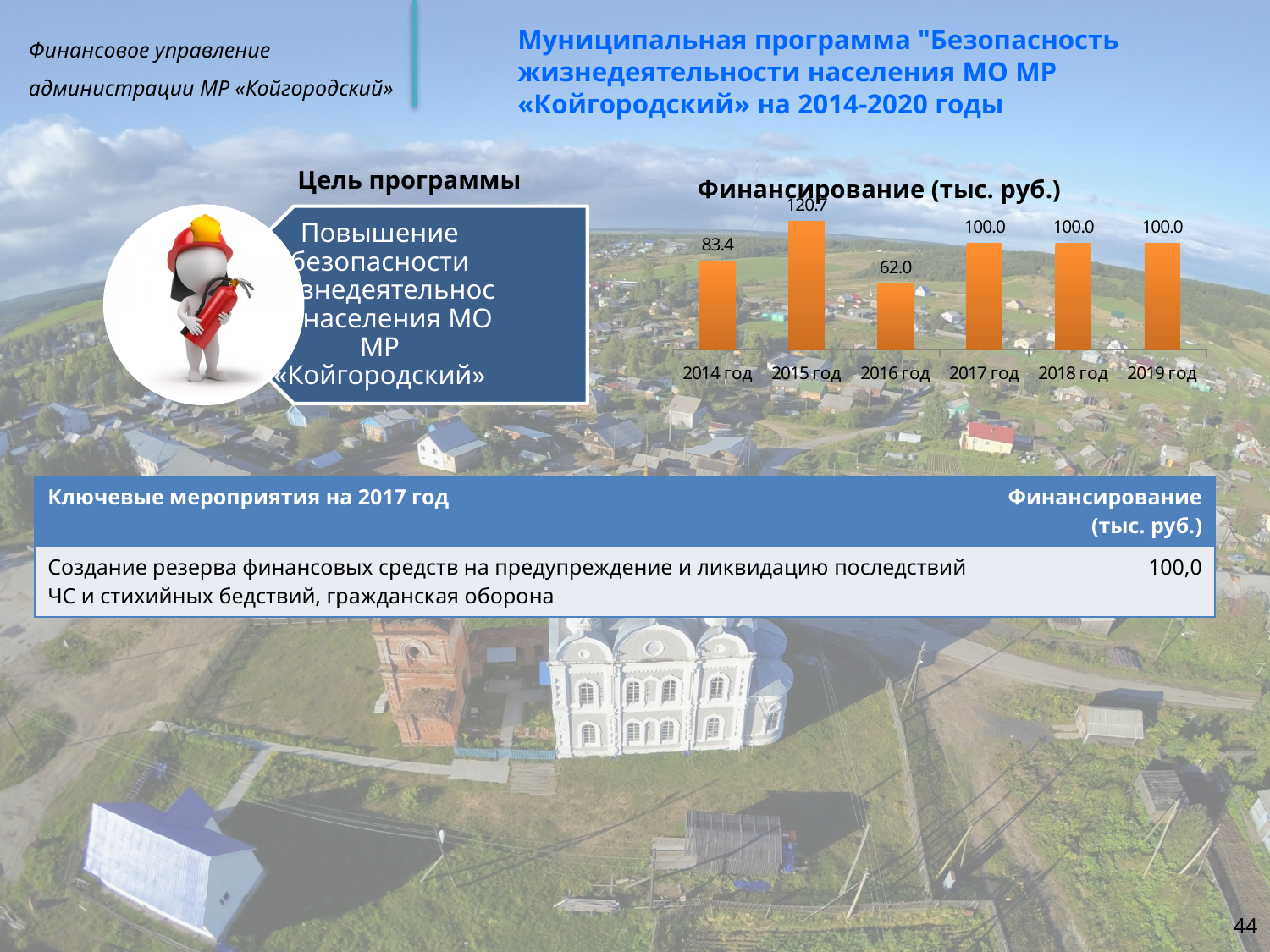
What kind of chart is shown on the slide? bar chart What is the title of the chart? Финансирование (тыс. руб.) Which year has the highest value in the chart? 2015 год What is the difference between the values for 2015 год and 2016 год? 58.7 Which year has the lowest value in the chart? 2016 год What is the value for 2015 год in the chart? 120.7 Which is larger, the value for 2014 год or the value for 2016 год? 2014 год What is the value for 2017 год in the chart? 100.0 How many years are shown in the chart? 6 What is the difference between the values for 2017 год and 2014 год? 16.6 What is the value for 2016 год in the chart? 62.0 What is the value for 2014 год in the chart? 83.4